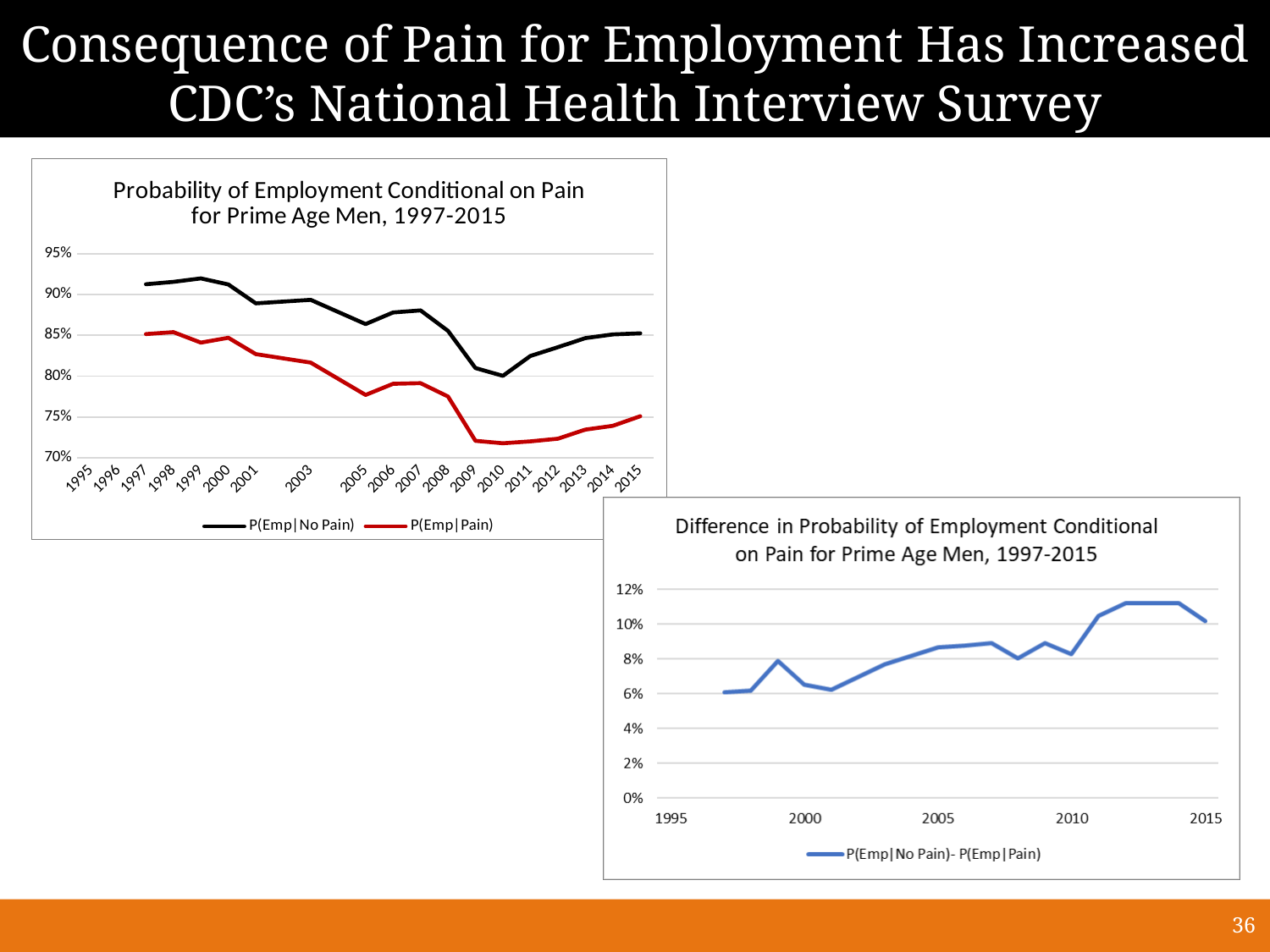
In the left chart, is the value of P(Emp|No Pain) in 2015 greater or less than 80%? greater In the left chart, what colour is the P(Emp|Pain) line? Red In the right chart, does the difference in probability of employment overall rise or fall from 1997 to 2015? rise What is the legend label of the series in the right chart? P(Emp|No Pain)- P(Emp|Pain) In the left chart, is the value of P(Emp|No Pain) in 1997 greater or less than 90%? greater How many series does the legend of the left chart list? 2 In the right chart, is the value in 2012 greater or less than 10%? greater In the left chart, which series is higher in 2005, P(Emp|No Pain) or P(Emp|Pain)? P(Emp|No Pain) How many series does the legend of the right chart, 'Difference in Probability of Employment Conditional on Pain', list? 1 What kind of chart is the left chart, 'Probability of Employment Conditional on Pain for Prime Age Men, 1997-2015'? Line chart